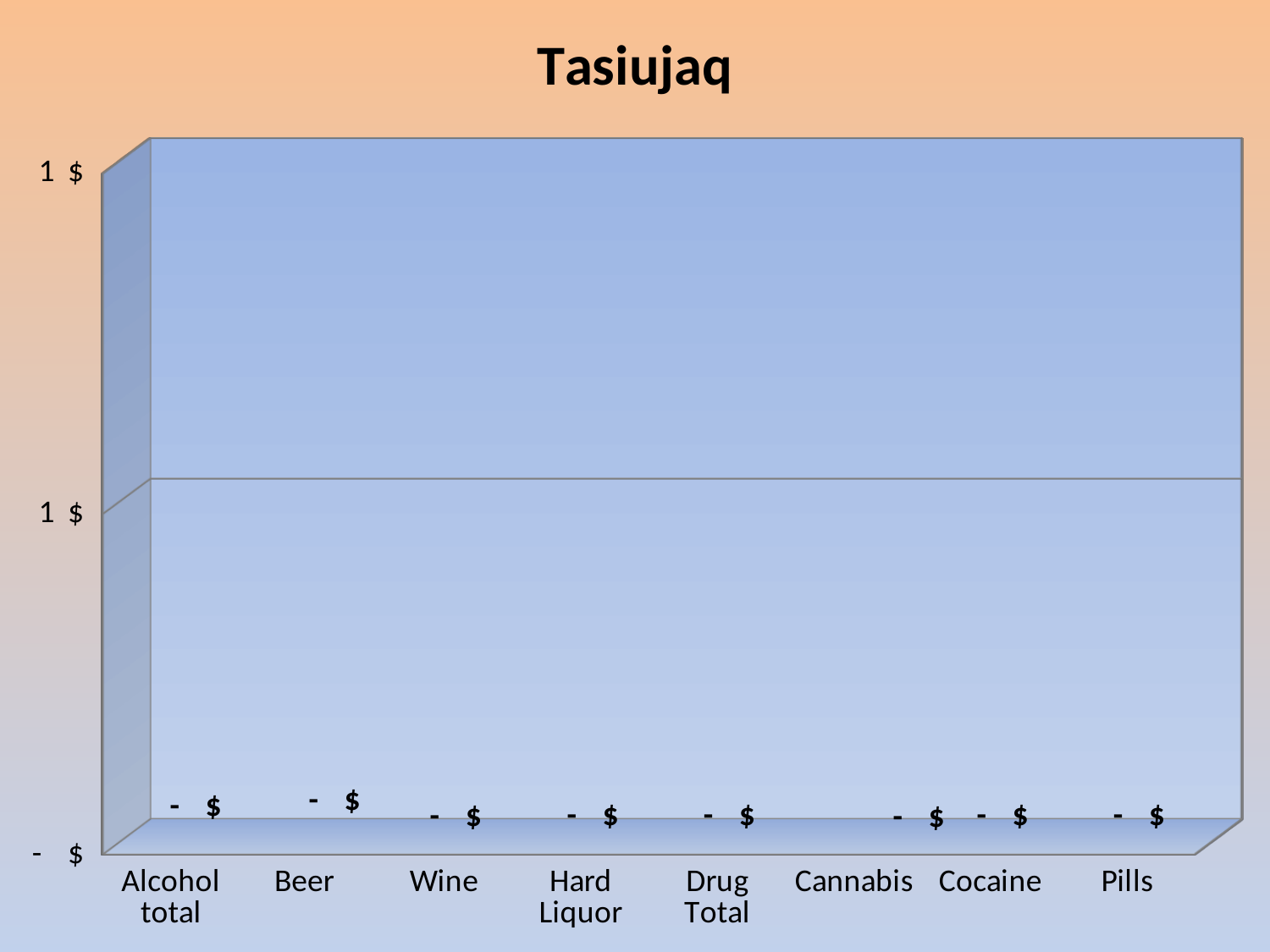
What value is labelled for Alcohol total? - $ What value is labelled for Beer? - $ What is the first category listed on the x axis? Alcohol total Is the value for Cocaine greater or less than 1 $? less What kind of chart is shown on the slide? bar chart What is the title of the chart? Tasiujaq Is the value for Wine greater or less than 1 $? less How many categories are shown on the x axis of the chart? 8 What value is labelled for Cannabis? - $ What value is labelled for Pills? - $ What value is labelled for Drug Total? - $